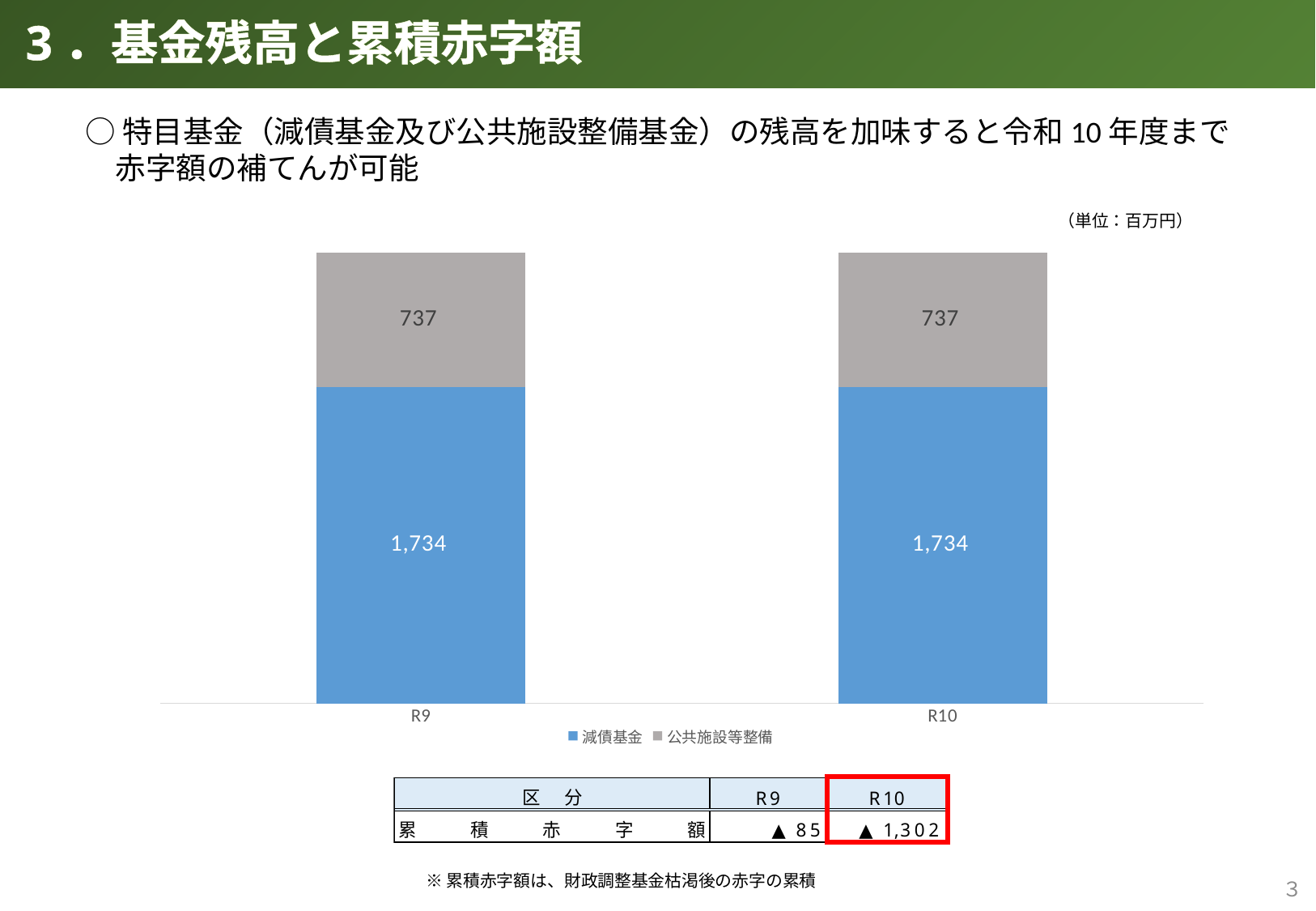
What kind of chart is shown on the slide? Stacked bar chart What is the value of 減債基金 for R9? 1,734 Which series is larger for R10, 減債基金 or 公共施設等整備? 減債基金 What is the difference between 減債基金 and 公共施設等整備 for R9? 997 What is the total of the stacked bar for R10? 2,471 What is the value of 公共施設等整備 for R9? 737 How many categories are shown on the x axis of the chart? 2 What is the value of 公共施設等整備 for R10? 737 What is the value of 減債基金 for R10? 1,734 What is the total of the stacked bar for R9? 2,471 How many series does the chart legend list? 2 Which colour represents 減債基金 in the chart? Blue